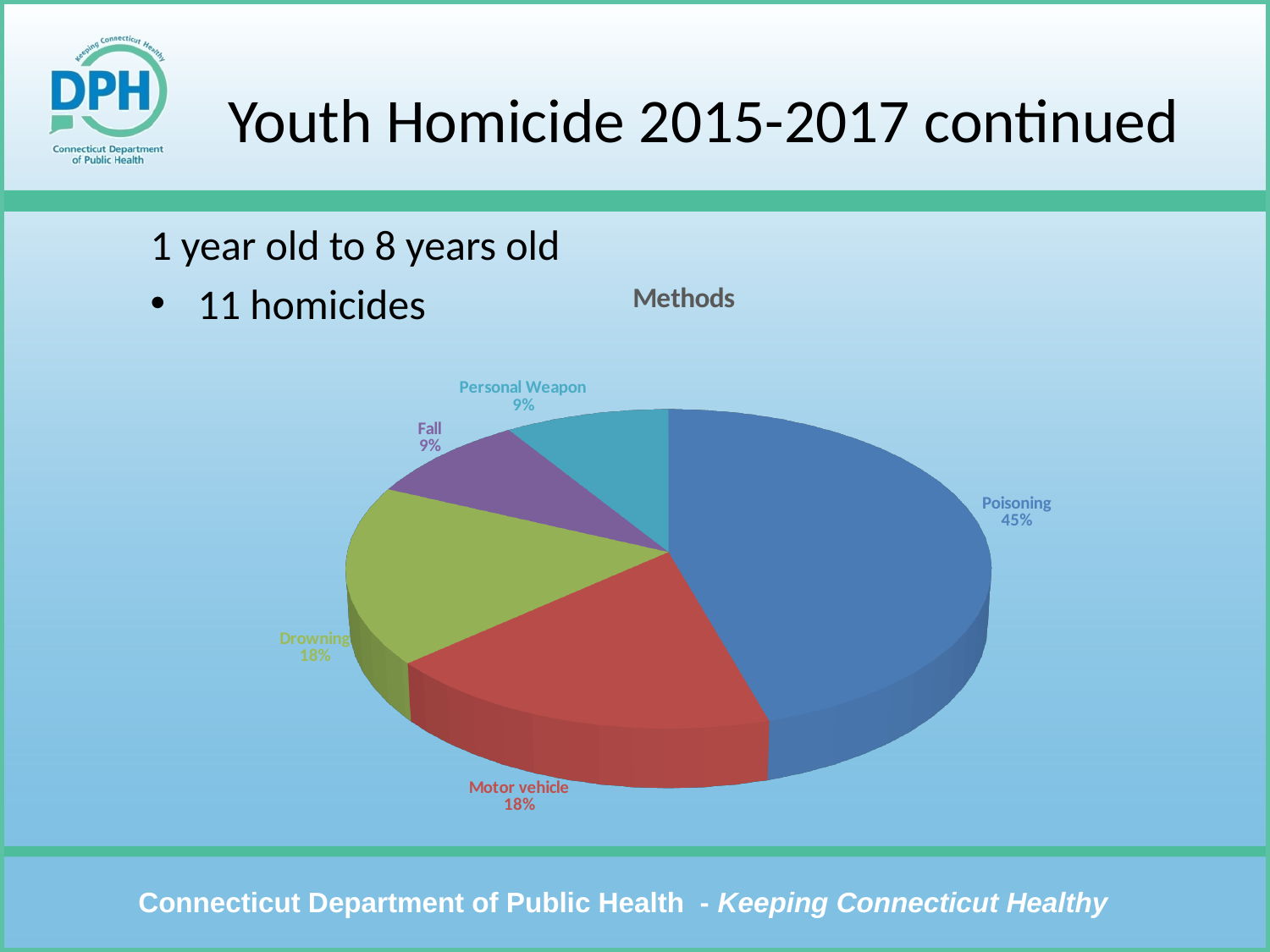
Which method has the largest slice of the pie? Poisoning What percentage is shown for Fall? 9% What percentage is shown for Motor vehicle? 18% What colour is the Poisoning slice? Blue How many slices does the pie chart have? 5 What percentage is shown for Drowning? 18% What type of chart is shown on the slide? Pie chart What share of the pie does Poisoning account for? 45% What is the title of the chart? Methods What percentage is shown for Personal Weapon? 9% Which is larger, the share for Drowning or the share for Fall? Drowning What is the difference in percentage points between Poisoning and Motor vehicle? 27